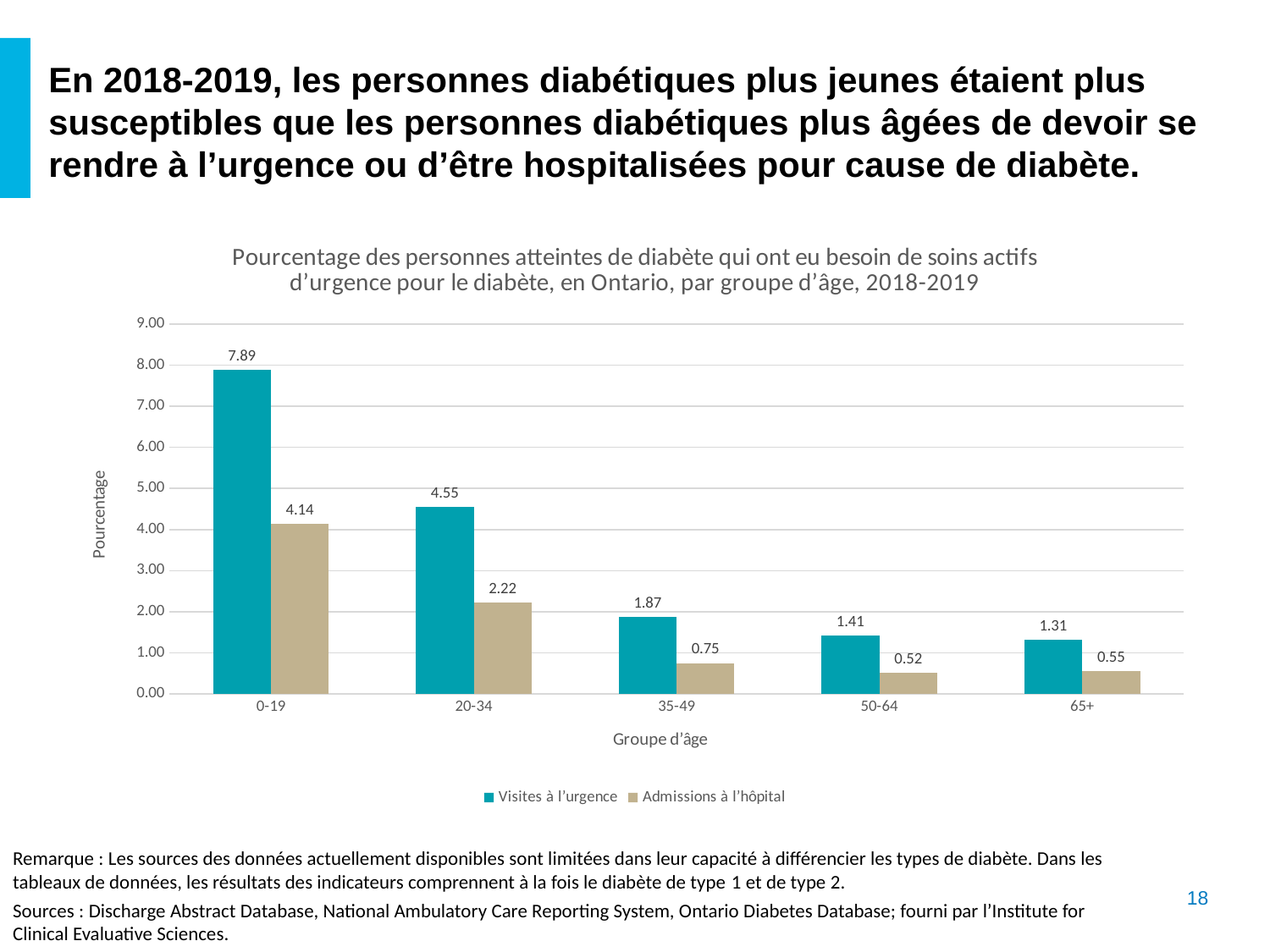
Which is larger: Visites à l'urgence for 35-49 or Visites à l'urgence for 50-64? Visites à l'urgence for 35-49 Which age group has the highest value for Visites à l'urgence? 0-19 How many age groups are shown on the x axis? 5 Is the value for Visites à l'urgence in the 20-34 age group greater or less than 4.00? greater Which age group has the lowest value for Admissions à l'hôpital? 50-64 Do the values for Visites à l'urgence rise or fall as the age group increases along the x axis? Fall What is the value for Visites à l'urgence in the 0-19 age group? 7.89 What is the value for Admissions à l'hôpital in the 20-34 age group? 2.22 What kind of chart is shown on the slide? Bar chart How many series does the legend list? 2 What is the difference between Visites à l'urgence and Admissions à l'hôpital in the 0-19 age group? 3.75 What is the value for Admissions à l'hôpital in the 65+ age group? 0.55